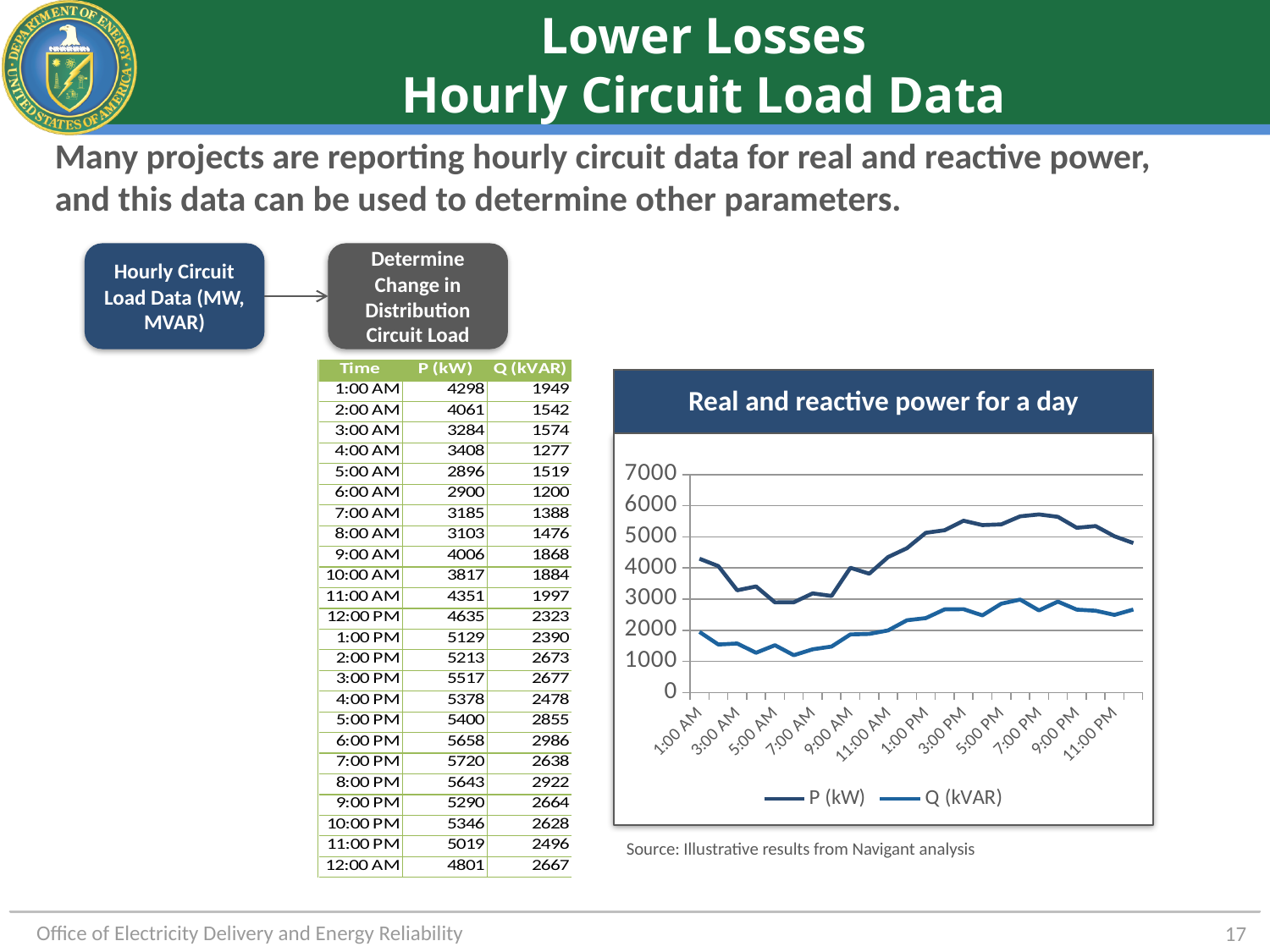
What is the value of P (kW) at 1:00 AM? 4298 Which is larger, P (kW) at 5:00 PM or P (kW) at 9:00 AM? P (kW) at 5:00 PM What is the value of Q (kVAR) at 12:00 PM? 2323 At what time does P (kW) reach its highest value? 7:00 PM What is the difference between P (kW) and Q (kVAR) at 12:00 PM? 2312 How many hourly data points are plotted for each series in the "Real and reactive power for a day" chart? 24 What are the two series named in the legend of the "Real and reactive power for a day" chart? P (kW) and Q (kVAR) What type of chart is shown under the title "Real and reactive power for a day"? line chart What is the highest value of P (kW) during the day? 5720 How many series does the legend of the "Real and reactive power for a day" chart list? 2 Is the value of P (kW) at 1:00 AM greater or less than 4000? greater Does the P (kW) line rise or fall between 1:00 AM and 5:00 AM? fall